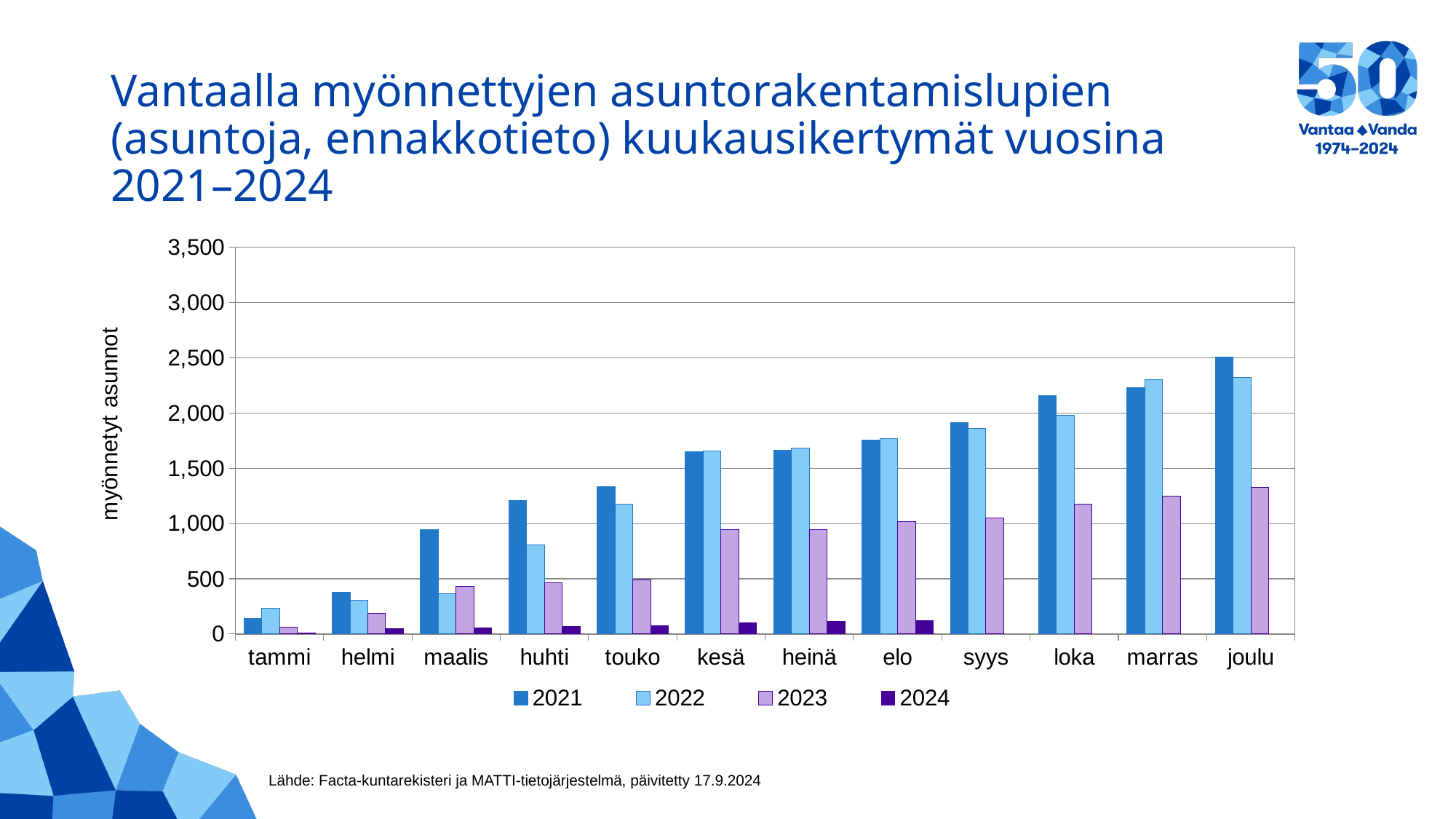
In loka, which series has the larger value, 2021 or 2022? 2021 Which month has the lowest value for the 2021 series? tammi Is the value for 2021 in joulu greater or less than 2,000? greater Is the value for 2023 in joulu greater or less than 1,500? less Do the values for the 2023 series rise or fall from tammi to joulu? rise How many months are shown on the x axis? 12 In huhti, which series has the larger value, 2021 or 2022? 2021 How many series does the legend list? 4 What is the label on the y axis? myönnetyt asunnot Is the value for 2022 in huhti greater or less than 1,000? less What kind of chart is shown on the slide? bar chart Which month has the highest value for the 2021 series? joulu